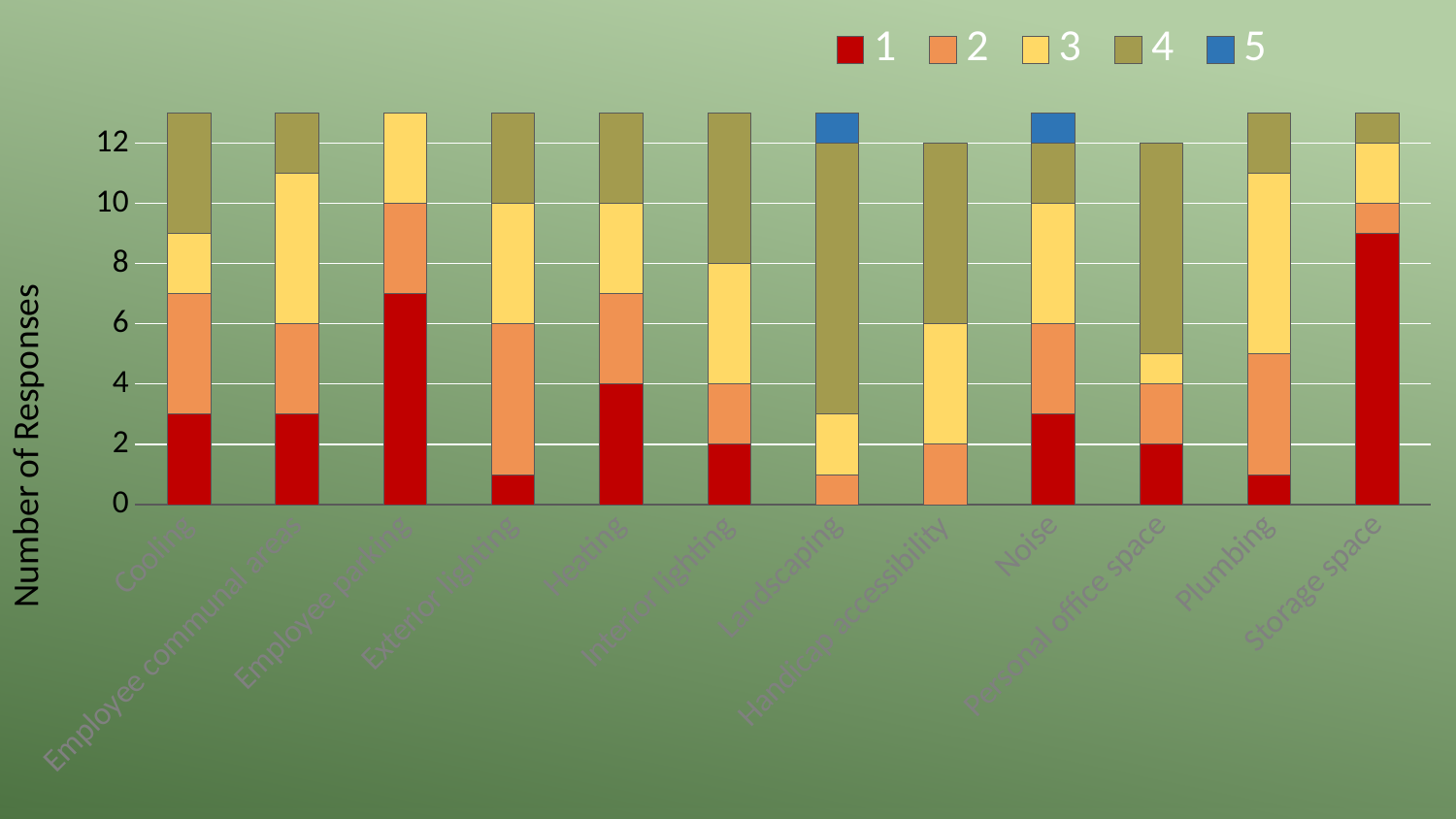
What is the value of series 1 for Interior lighting? 2 What is the total height of the stacked bar for Personal office space? 12 Which categories include a series 5 segment? Landscaping and Noise What is the total height of the stacked bar for Handicap accessibility? 12 Which is larger, the series 1 value for Employee parking or for Cooling? Employee parking Which category has the largest series 1 segment? Storage space How many series does the legend list? 5 Is the series 1 value for Storage space greater or less than 8? greater What is the value of series 1 for Heating? 4 What is the title of the vertical axis? Number of Responses How many categories are shown along the x axis? 12 What kind of chart is shown on the slide? Stacked bar chart